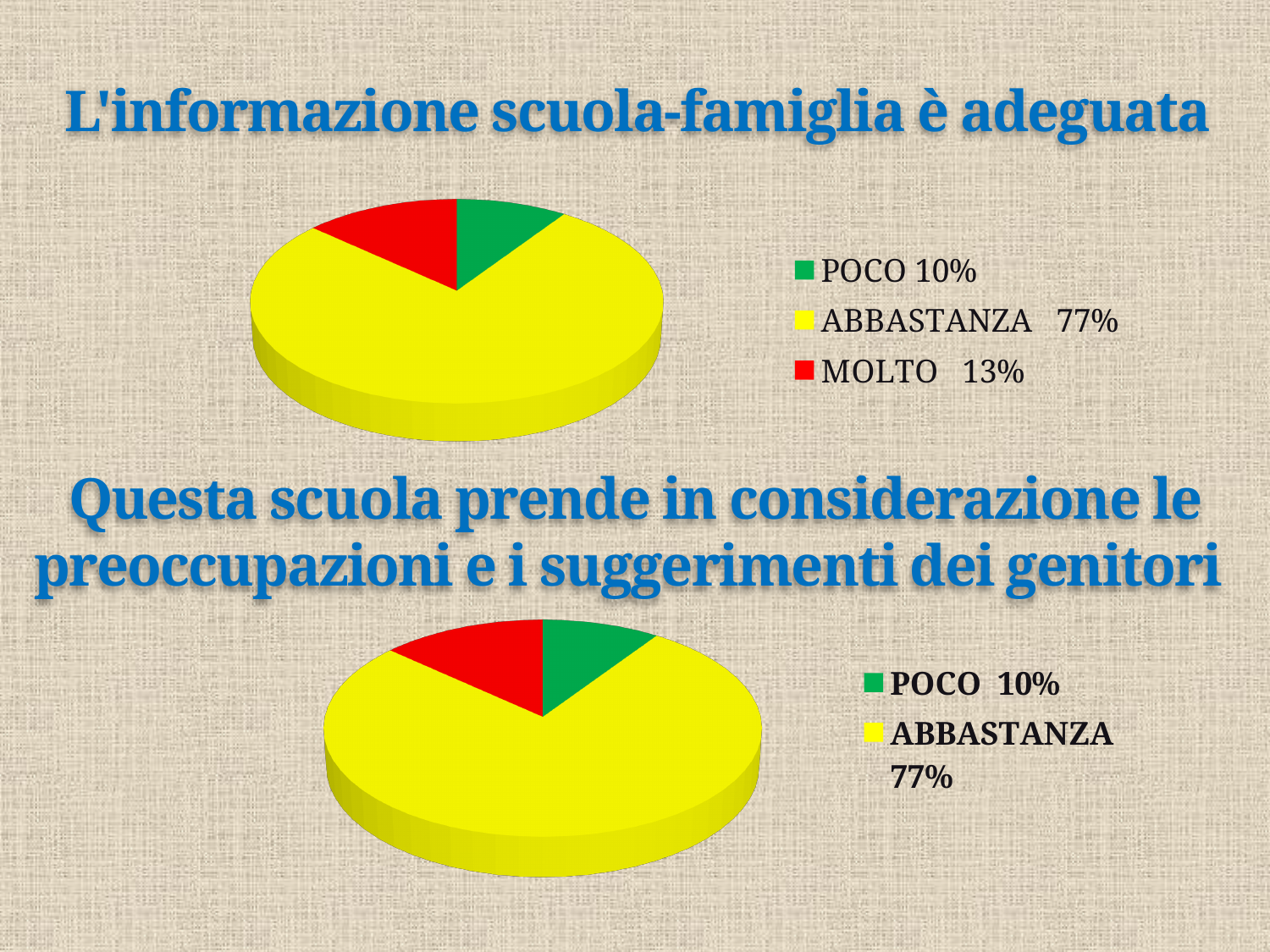
What kind of chart is used on this slide? Pie chart In the bottom chart, titled "Questa scuola prende in considerazione le preoccupazioni e i suggerimenti dei genitori", what percentage is shown for ABBASTANZA? 77% In the chart titled "L'informazione scuola-famiglia è adeguata", which category has the smallest share? POCO In the top chart, what colour is the slice for MOLTO? Red In the chart titled "L'informazione scuola-famiglia è adeguata", what percentage is shown for MOLTO? 13% How many categories does the legend of the top chart list? 3 In the chart titled "L'informazione scuola-famiglia è adeguata", what percentage is shown for ABBASTANZA? 77% In the chart titled "L'informazione scuola-famiglia è adeguata", which is larger, MOLTO or POCO? MOLTO In the chart titled "L'informazione scuola-famiglia è adeguata", what percentage is shown for POCO? 10% In the chart titled "L'informazione scuola-famiglia è adeguata", which category has the largest share? ABBASTANZA In the bottom chart, titled "Questa scuola prende in considerazione le preoccupazioni e i suggerimenti dei genitori", what percentage is shown for POCO? 10% In the chart titled "L'informazione scuola-famiglia è adeguata", what is the difference in percentage points between ABBASTANZA and MOLTO? 64